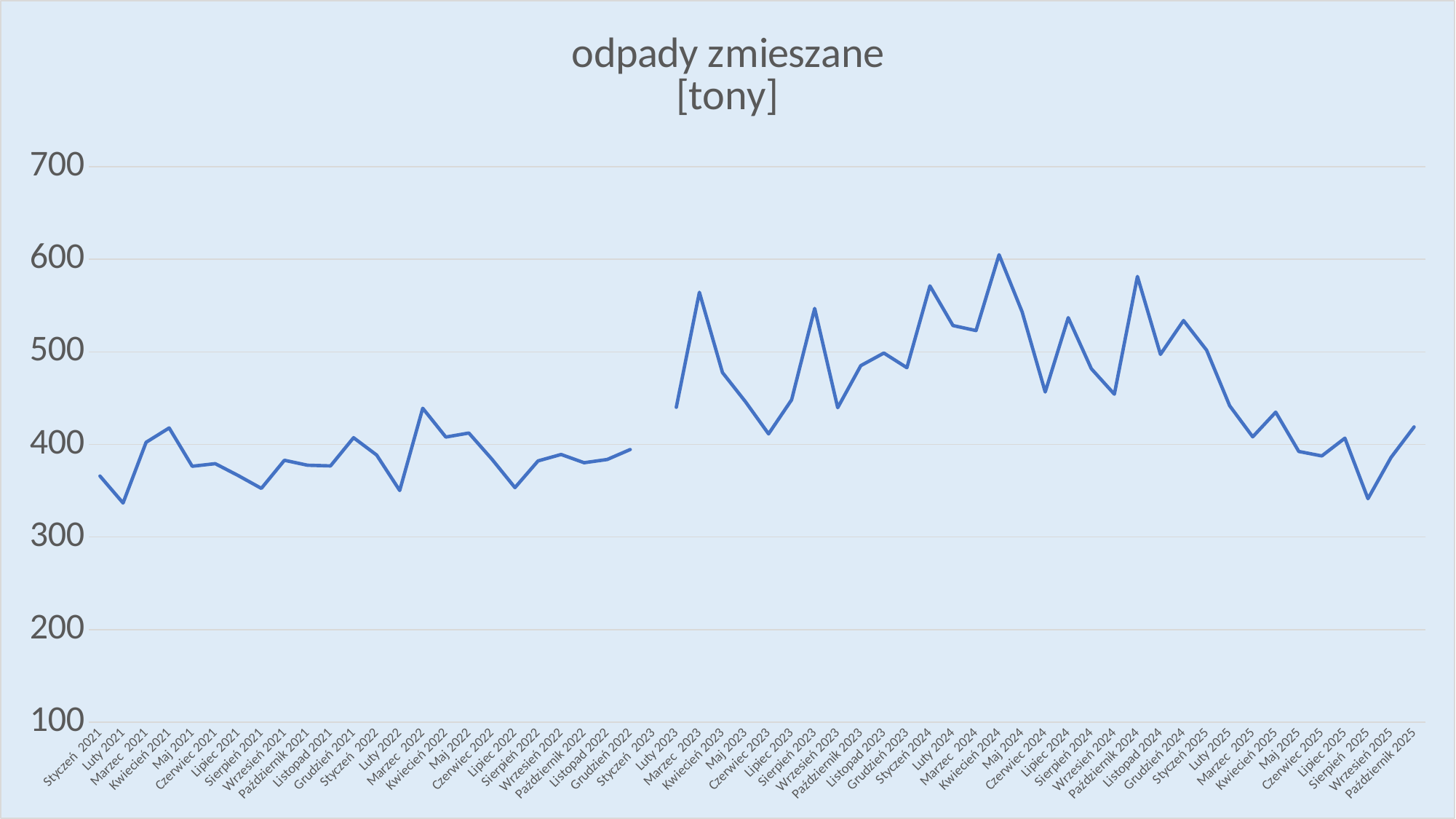
Which month has the highest value on the chart? Kwiecień 2024 What is the title of the chart? odpady zmieszane [tony] What kind of chart is shown on the slide? line chart Is the value for Luty 2021 greater or less than 400? less Is the value for Czerwiec 2023 greater or less than 500? less Which is larger, the value for Marzec 2023 or the value for Marzec 2022? Marzec 2023 Is the value for Marzec 2023 greater or less than 500? greater Do the values rise or fall from Kwiecień 2024 to Czerwiec 2024? fall Which is larger, the value for Kwiecień 2024 or the value for Kwiecień 2021? Kwiecień 2024